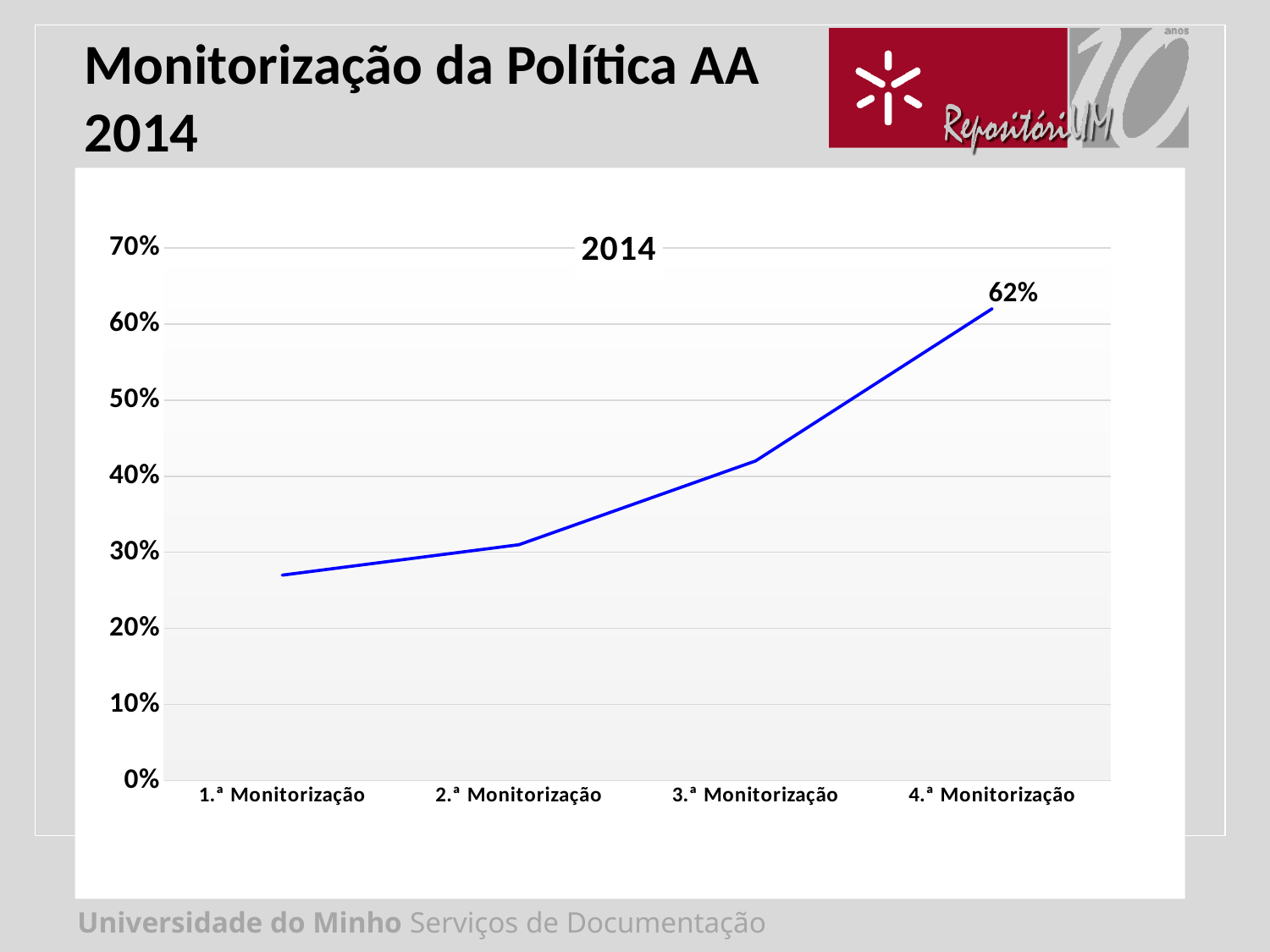
What is the highest value shown on the vertical axis? 70% What is the value for 4.ª Monitorização? 62% Do the values rise or fall from 1.ª Monitorização to 4.ª Monitorização? rise Is the value for 2.ª Monitorização greater or less than 40%? less How many monitoring points are plotted on the chart? 4 What is the title of the chart? 2014 What type of chart is shown on the slide? line chart Which monitoring point has the highest value? 4.ª Monitorização Is the value for 3.ª Monitorização greater or less than 50%? less Is the value for 1.ª Monitorização greater or less than 30%? less Which monitoring point has the lowest value? 1.ª Monitorização Which is larger, the value for 3.ª Monitorização or the value for 2.ª Monitorização? 3.ª Monitorização